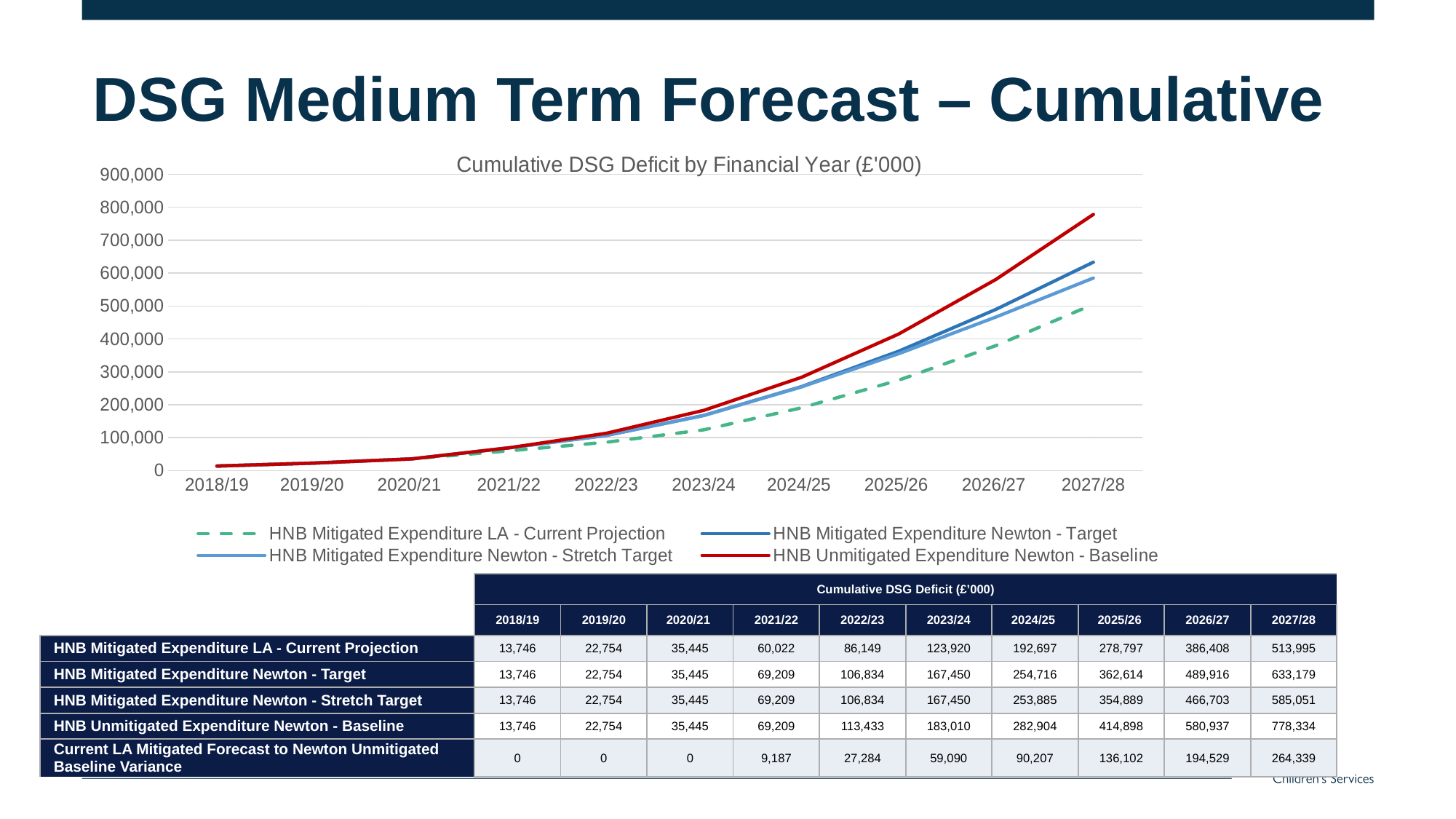
What kind of chart is shown on the slide? line chart Is the value for HNB Unmitigated Expenditure Newton - Baseline in 2027/28 greater or less than 700,000? greater Which series has the highest value in 2027/28? HNB Unmitigated Expenditure Newton - Baseline In 2027/28, which is larger: HNB Mitigated Expenditure Newton - Target or HNB Mitigated Expenditure Newton - Stretch Target? HNB Mitigated Expenditure Newton - Target How many series does the chart legend list? 4 What is the value for HNB Mitigated Expenditure Newton - Target in 2024/25? 254,716 What is the value for HNB Unmitigated Expenditure Newton - Baseline in 2027/28? 778,334 What is the value for HNB Mitigated Expenditure LA - Current Projection in 2027/28? 513,995 What is the difference between HNB Unmitigated Expenditure Newton - Baseline and HNB Mitigated Expenditure LA - Current Projection in 2027/28? 264,339 Do the values of the HNB Unmitigated Expenditure Newton - Baseline series rise or fall from 2018/19 to 2027/28? rise Which series has the lowest value in 2027/28? HNB Mitigated Expenditure LA - Current Projection How many financial years are plotted along the x axis of the chart? 10